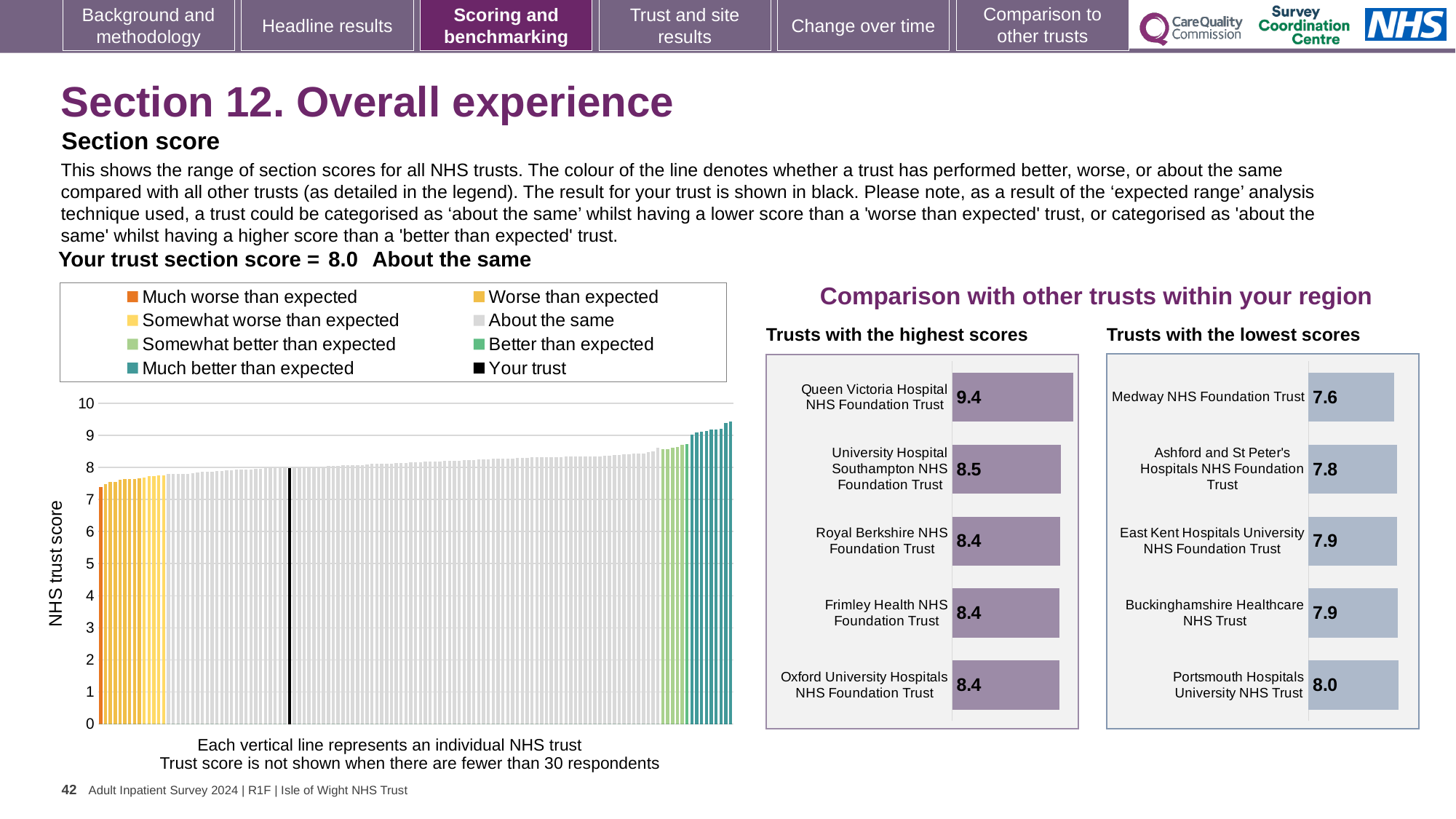
In the 'Trusts with the highest scores' chart, what is the score for University Hospital Southampton NHS Foundation Trust? 8.5 In the 'Trusts with the highest scores' chart, what is the score for Queen Victoria Hospital NHS Foundation Trust? 9.4 In the left-hand 'NHS trust score' chart, is the value of the tallest bar greater or less than 9? greater In the 'Trusts with the highest scores' chart, what is the difference between the scores of Queen Victoria Hospital NHS Foundation Trust and University Hospital Southampton NHS Foundation Trust? 0.9 In the 'Trusts with the highest scores' chart, which trust has the highest score? Queen Victoria Hospital NHS Foundation Trust How many entries does the legend of the left-hand 'NHS trust score' chart list? 8 In the 'Trusts with the lowest scores' chart, what is the score for Medway NHS Foundation Trust? 7.6 In the 'Trusts with the lowest scores' chart, what is the score for Portsmouth Hospitals University NHS Trust? 8.0 Which is larger: the score for Royal Berkshire NHS Foundation Trust in the 'Trusts with the highest scores' chart or the score for East Kent Hospitals University NHS Foundation Trust in the 'Trusts with the lowest scores' chart? Royal Berkshire NHS Foundation Trust In the 'Trusts with the lowest scores' chart, which trust has the lowest score? Medway NHS Foundation Trust How many trusts are shown in the 'Trusts with the lowest scores' chart? 5 In the 'Trusts with the lowest scores' chart, what is the difference between the scores of Portsmouth Hospitals University NHS Trust and Medway NHS Foundation Trust? 0.4